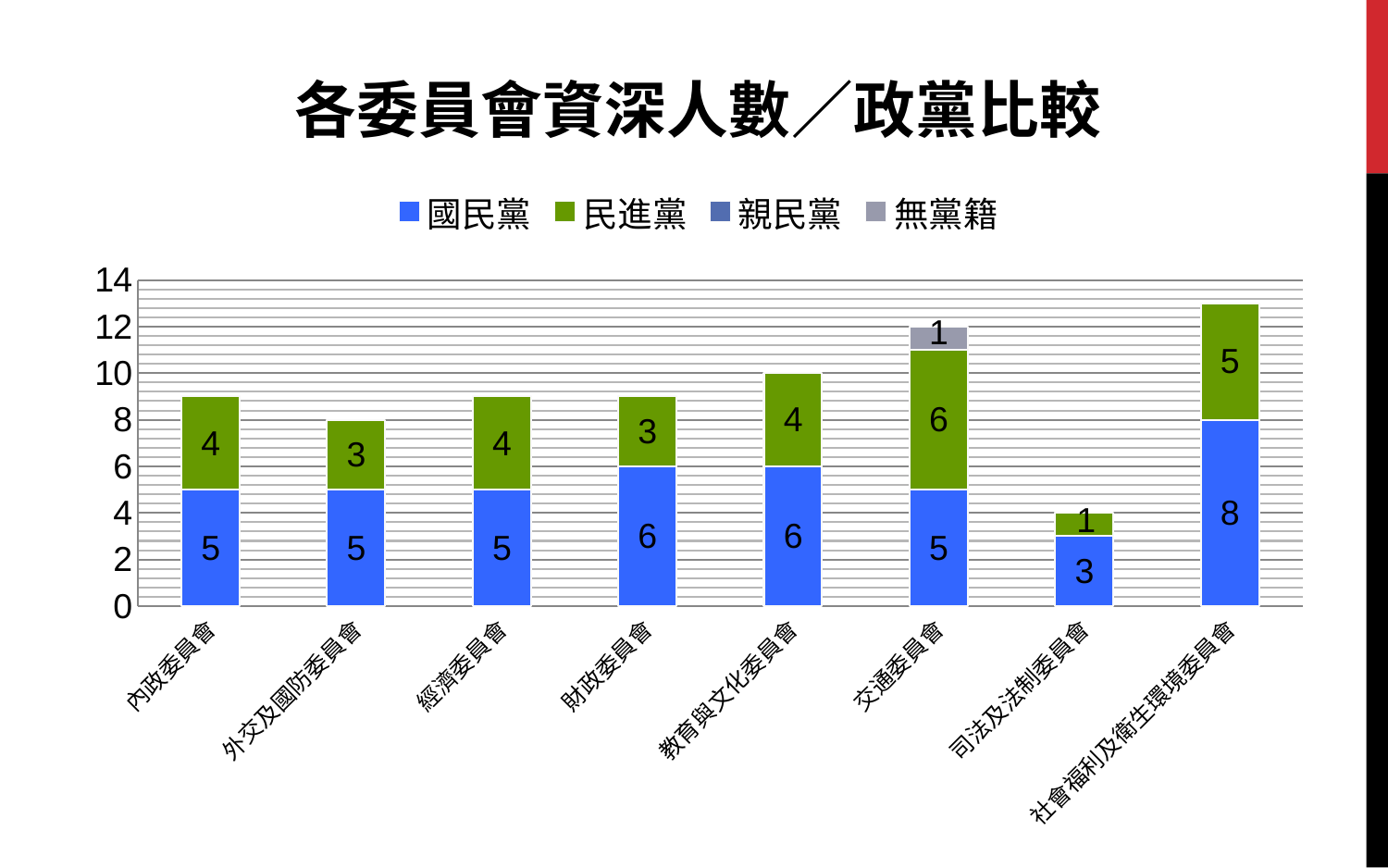
What is the value for 民進黨 in 交通委員會? 6 What kind of chart is shown on the slide? Stacked bar chart How many committees (categories) are shown on the x axis? 8 Which is larger: the 民進黨 value for 財政委員會 or the 民進黨 value for 教育與文化委員會? 教育與文化委員會 How many series does the legend list? 4 Which committee has the lowest total stacked bar? 司法及法制委員會 What is the value for 無黨籍 in 交通委員會? 1 What is the total of the stacked bar for 交通委員會? 12 Which committee has the highest total stacked bar? 社會福利及衛生環境委員會 What is the value for 民進黨 in 司法及法制委員會? 1 What is the value for 國民黨 in 社會福利及衛生環境委員會? 8 What is the difference between the 國民黨 value for 社會福利及衛生環境委員會 and the 國民黨 value for 司法及法制委員會? 5